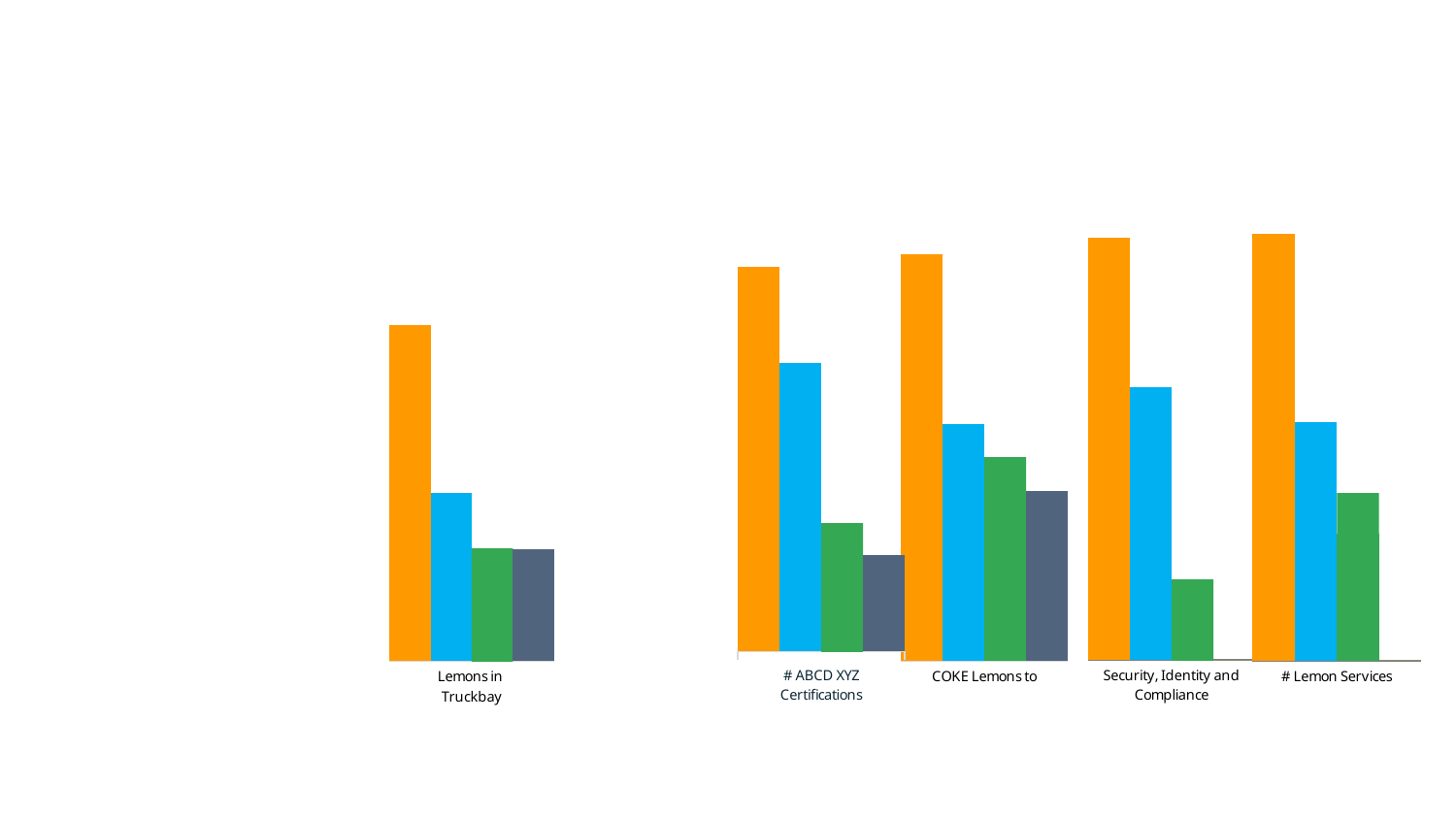
How many categories are shown on the x axis of the right chart? 4 How many categories are shown on the x axis of the left chart? 1 In the right chart, how many bars are plotted for "Security, Identity and Compliance"? 3 What kind of chart is the right chart? bar chart In the left chart, which colour bar is the tallest for "Lemons in Truckbay"? orange In the right chart, is the orange bar taller for "# Lemon Services" or for "# ABCD XYZ Certifications"? # Lemon Services